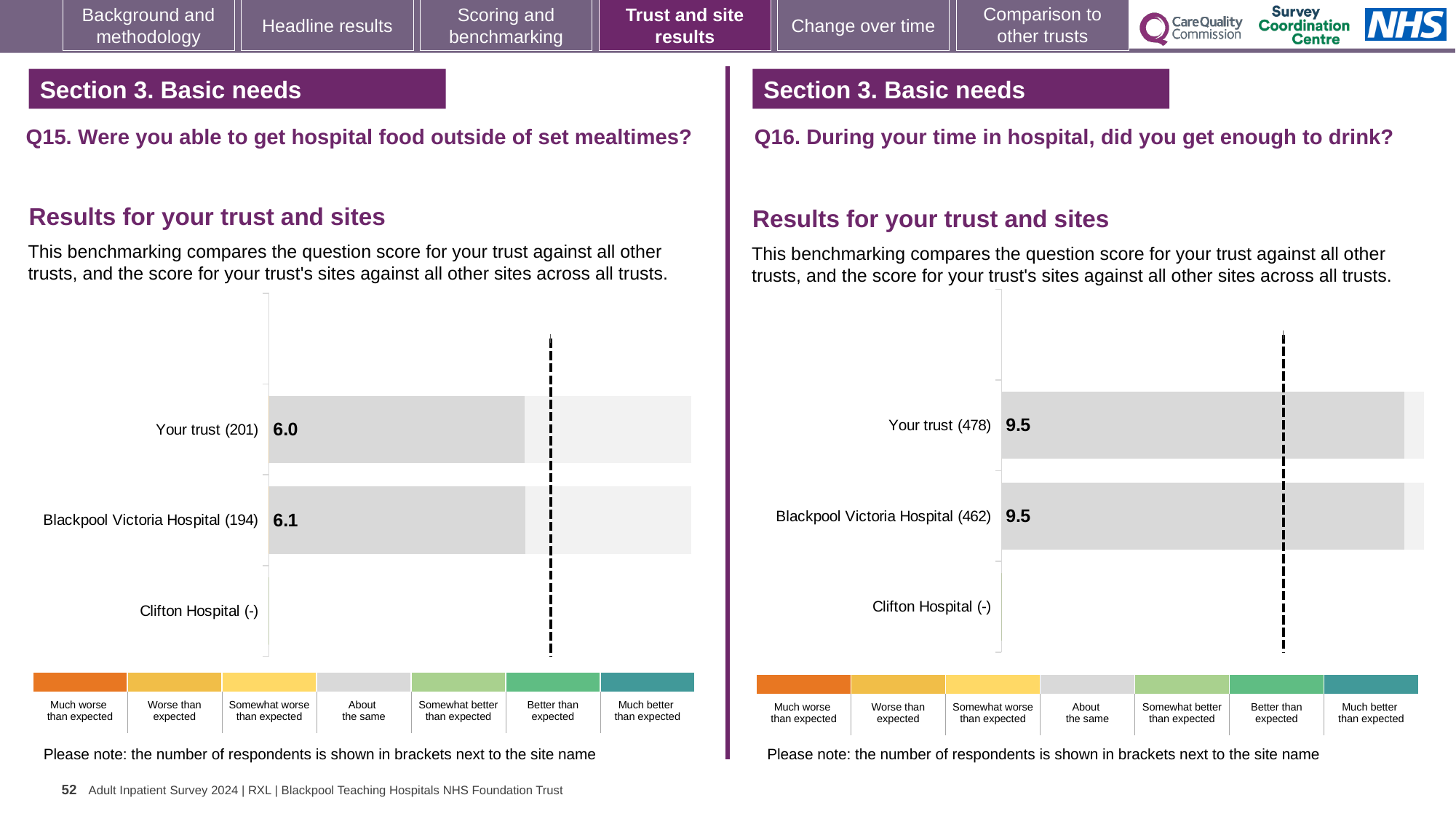
In the Q15 chart (hospital food outside of set mealtimes), what is the score for Blackpool Victoria Hospital? 6.1 In the Q16 chart, how many respondents are shown in brackets for Blackpool Victoria Hospital? 462 In the Q15 chart (hospital food outside of set mealtimes), what is the score for Your trust? 6.0 In the Q16 chart (did you get enough to drink), what is the score for Your trust? 9.5 In the Q15 chart, which benchmark band do the bars for Your trust and Blackpool Victoria Hospital fall into according to the colour key? About the same What kind of chart is used in the Q16 chart? Bar chart In the Q16 chart, which category has no score shown (marked with a dash)? Clifton Hospital In the Q15 chart, what is the difference between the Blackpool Victoria Hospital score and the Your trust score? 0.1 In the Q15 chart, how many site/trust categories are listed on the vertical axis? 3 In the Q16 chart, is the score for Your trust greater or less than the score for Blackpool Victoria Hospital, or are they equal? Equal In the Q16 chart (did you get enough to drink), what is the score for Blackpool Victoria Hospital? 9.5 In the Q15 chart, how many respondents are shown in brackets for Your trust? 201